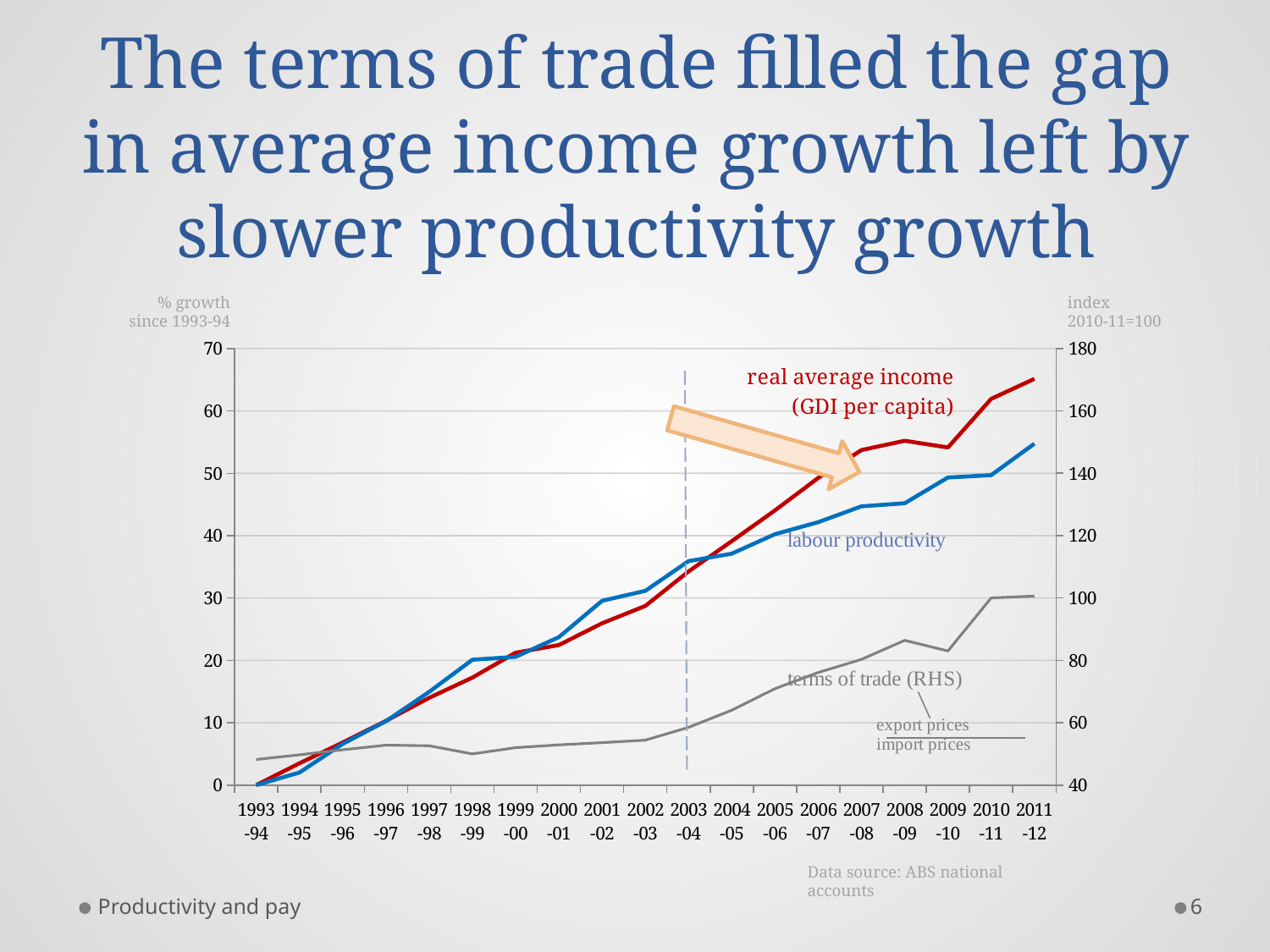
Does the real average income (GDI per capita) line rise or fall from 1993-94 to 2011-12? rise Is the value for labour productivity in 2011-12 greater or less than 50? greater What kind of chart is shown on the slide? line chart Is the value for real average income (GDI per capita) in 2011-12 greater or less than 60? greater In 1998-99, which is higher: labour productivity or real average income (GDI per capita)? labour productivity How many years are shown along the x axis of the chart? 19 What is the data source given for the chart? ABS national accounts Is the value for labour productivity in 2003-04 greater or less than 30? greater How many series (lines) are plotted on the chart? 3 Which series is plotted against the right-hand axis? terms of trade In 2011-12, which is higher: real average income (GDI per capita) or labour productivity? real average income (GDI per capita)